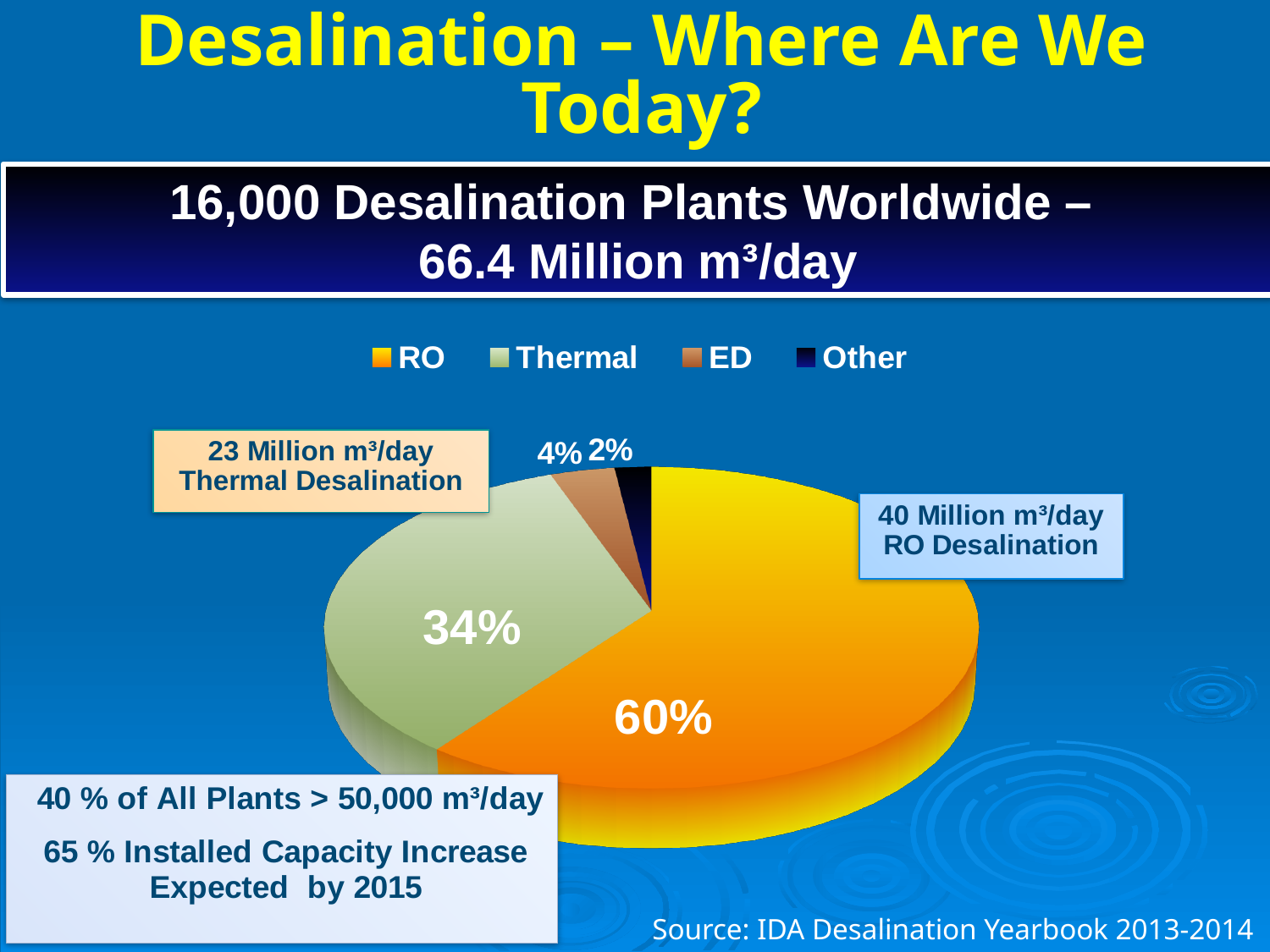
What type of chart is shown on the slide? pie chart What share of the pie does Other account for? 2% According to the callout on the chart, what is the capacity of Thermal desalination? 23 Million m³/day What share of the pie does Thermal account for? 34% What share of the pie does RO account for? 60% Which category has the smallest slice of the pie? Other What is the difference in percentage points between the RO and Thermal slices? 26 How many categories does the legend list? 4 Which slice is larger, ED or Other? ED According to the callout on the chart, what is the capacity of RO desalination? 40 Million m³/day Which category has the largest slice of the pie? RO